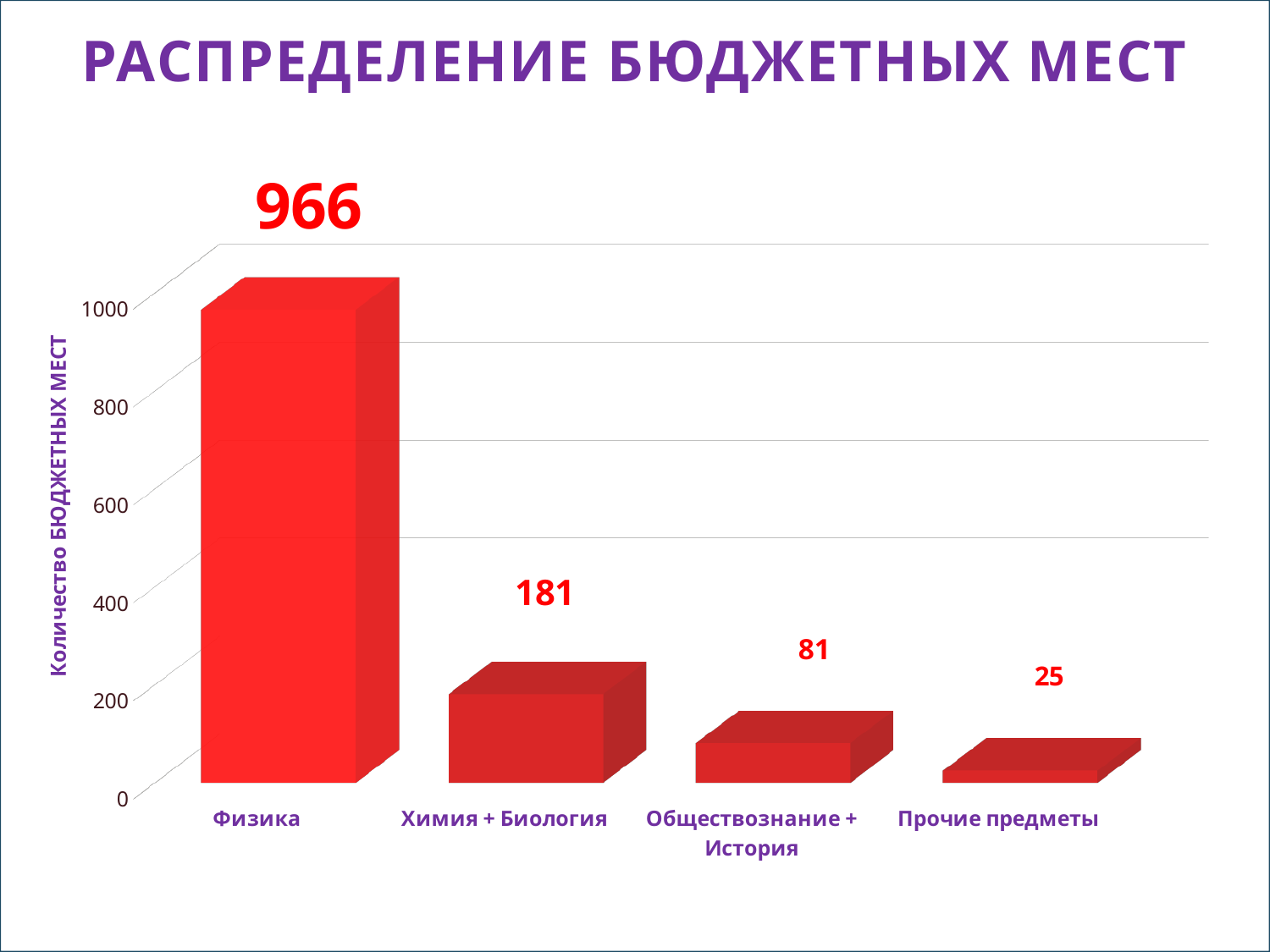
What is the value for Физика? 966 Which category has the highest value? Физика What kind of chart is shown on the slide? Bar chart How many categories are shown on the chart? 4 What is the value for Прочие предметы? 25 What is the difference between the values for Физика and Химия + Биология? 785 Which is larger, the value for Химия + Биология or the value for Обществознание + История? Химия + Биология What is the difference between the values for Обществознание + История and Прочие предметы? 56 Which category has the lowest value? Прочие предметы What is the title of the slide? РАСПРЕДЕЛЕНИЕ БЮДЖЕТНЫХ МЕСТ What is the value for Химия + Биология? 181 What is the value for Обществознание + История? 81